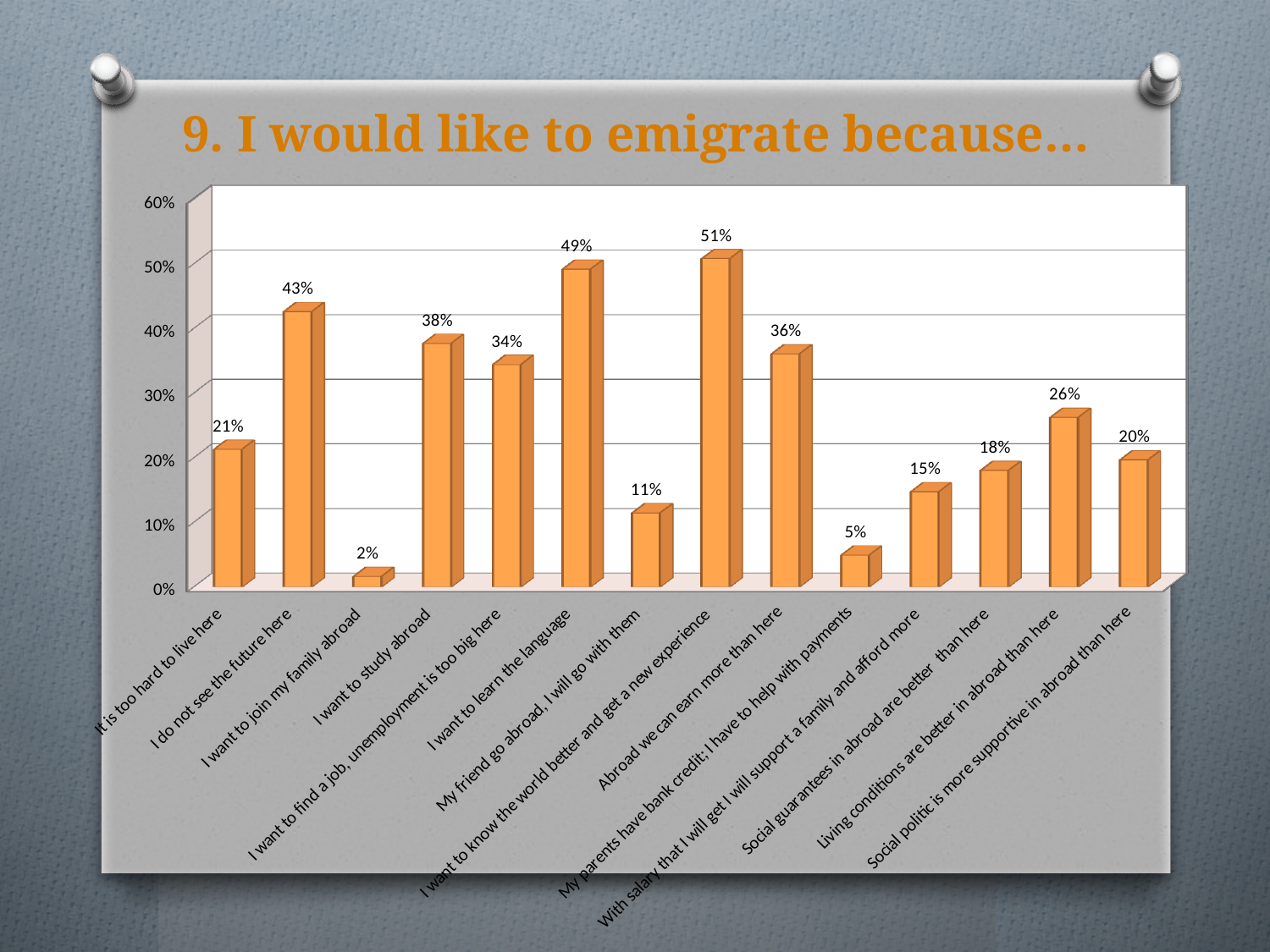
Is the value for "I want to find a job, unemployment is too big here" greater or less than 30%? greater What is the value shown for "Abroad we can earn more than here"? 36% What percentage is shown for "Living conditions are better in abroad than here"? 26% Which reason for emigrating has the highest percentage? I want to know the world better and get a new experience How many reasons for emigrating are shown on the chart? 14 Which has a higher value: "It is too hard to live here" or "Social politic is more supportive in abroad than here"? It is too hard to live here What is the difference in percentage points between "My friend go abroad, I will go with them" and "My parents have bank credit; I have to help with payments"? 6 Which reason for emigrating has the lowest percentage? I want to join my family abroad What is the title of the chart on the slide? 9. I would like to emigrate because... What type of chart is shown on the slide? Bar chart What is the difference in percentage points between "I want to learn the language" and "I do not see the future here"? 6 What percentage of respondents chose "I want to study abroad" as a reason to emigrate? 38%